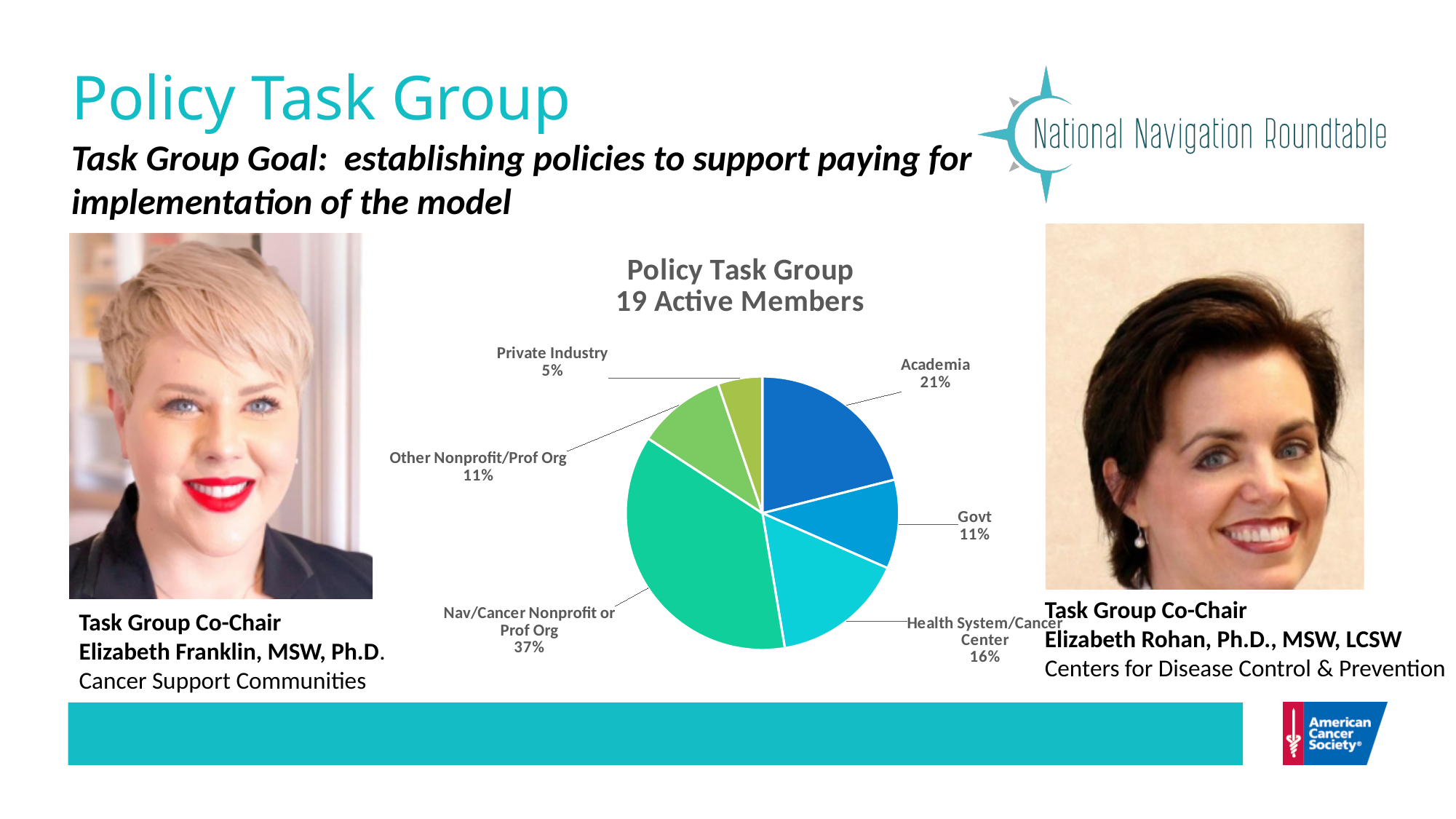
What is the title of the pie chart? Policy Task Group 19 Active Members What share of the pie does Nav/Cancer Nonprofit or Prof Org hold? 37% What share of the pie does Private Industry hold? 5% Which two categories each hold 11% of the pie? Govt and Other Nonprofit/Prof Org Which category has the smallest slice of the pie? Private Industry Which category has the largest slice of the pie? Nav/Cancer Nonprofit or Prof Org What share of the pie does Health System/Cancer Center hold? 16% How many categories are shown in the pie chart? 6 Which is larger, the share for Academia or the share for Health System/Cancer Center? Academia What share of the pie does Academia hold? 21% What is the difference in percentage points between Nav/Cancer Nonprofit or Prof Org and Academia? 16 What kind of chart is shown on the slide? Pie chart